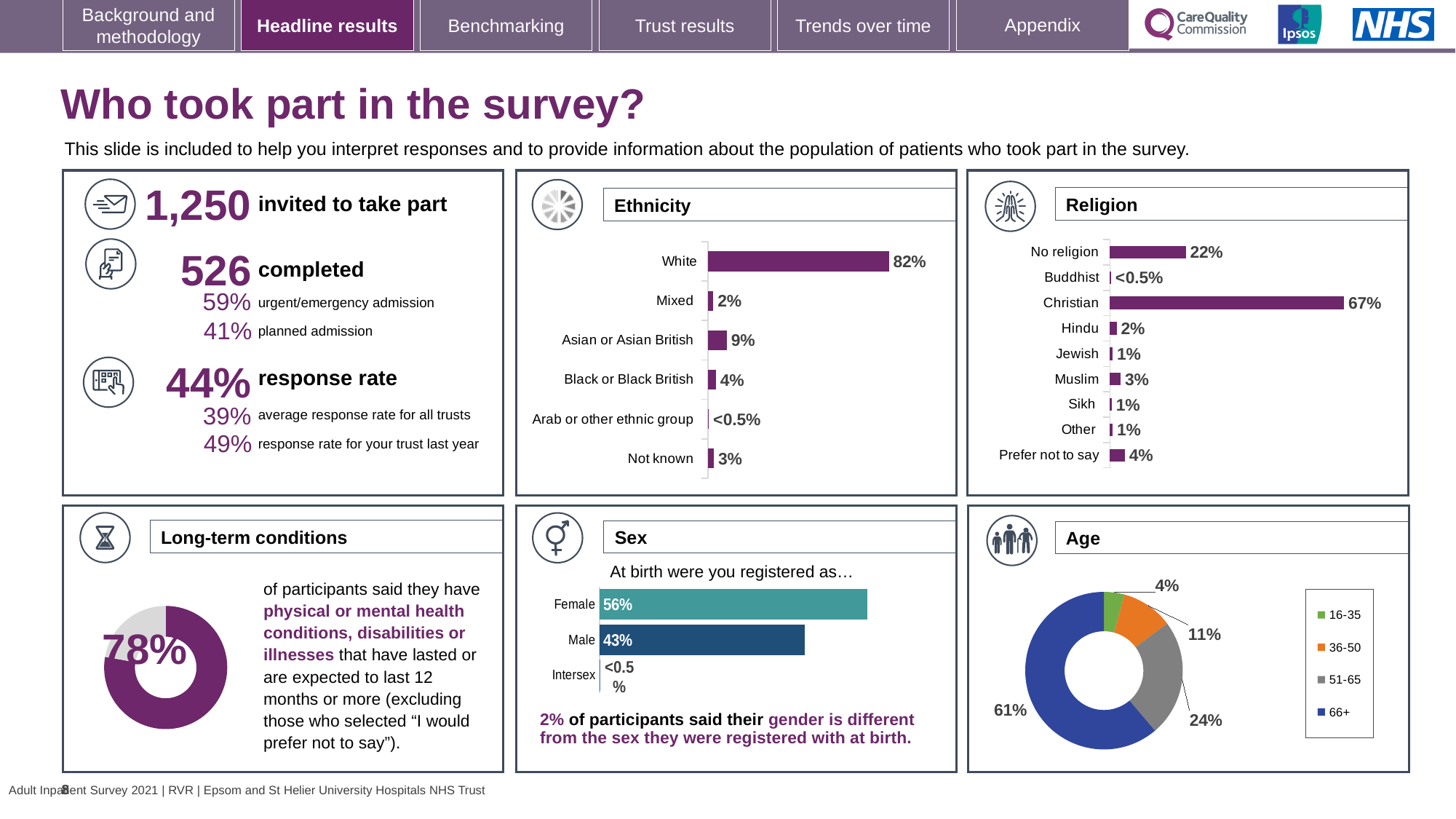
In the Ethnicity chart, what is the difference between the White and Asian or Asian British percentages? 73% In the Religion chart, what percentage of participants were Christian? 67% In the Religion chart, which category has the highest value? Christian In the Ethnicity chart, what percentage of participants were White? 82% In the Age chart, what share of participants were aged 66+? 61% In the Age chart, how many age groups does the legend list? 4 In the Sex chart, what percentage of participants were registered as Male at birth? 43% In the Religion chart, how many religion categories are listed? 9 In the Ethnicity chart, how many ethnicity categories are shown? 6 In the Ethnicity chart, which category has the lowest value? Arab or other ethnic group In the Sex chart, which is larger, the Female or the Male percentage? Female In the Religion chart, what is the difference between the Christian and No religion percentages? 45%